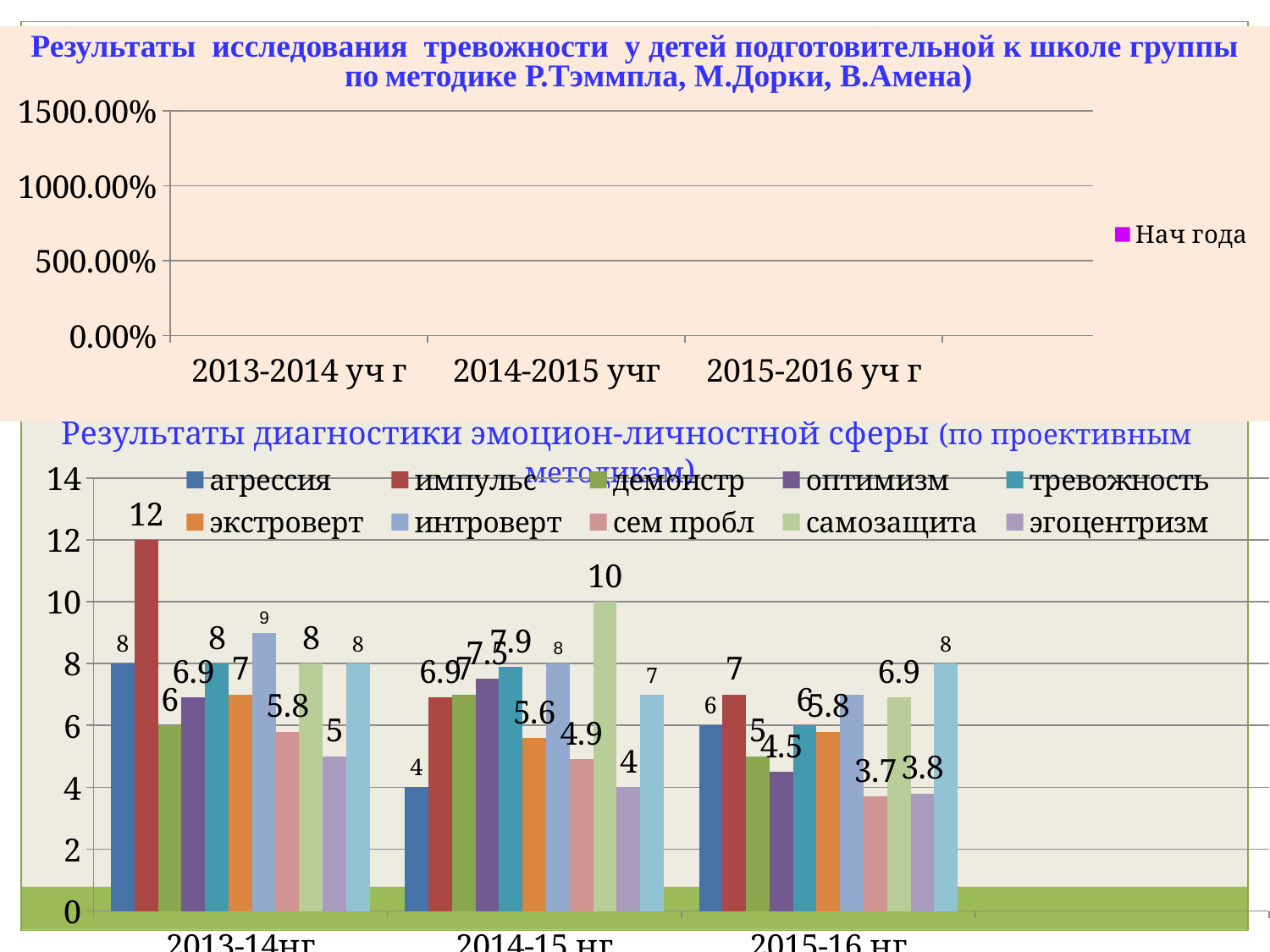
In the bottom chart 'Результаты диагностики эмоцион-личностной сферы', what is the value for импульс in 2013-14нг? 12 In the bottom chart 'Результаты диагностики эмоцион-личностной сферы', what is the difference between the импульс value in 2013-14нг and in 2014-15 нг? 5.1 In the bottom chart 'Результаты диагностики эмоцион-личностной сферы', what is the value for самозащита in 2014-15 нг? 10 In the bottom chart 'Результаты диагностики эмоцион-личностной сферы', how many series does the legend list? 10 In the bottom chart 'Результаты диагностики эмоцион-личностной сферы', how many year categories are shown on the x axis? 3 In the bottom chart 'Результаты диагностики эмоцион-личностной сферы', which series has the highest value in 2013-14нг? импульс In the bottom chart 'Результаты диагностики эмоцион-личностной сферы', do the values for сем пробл rise or fall from 2013-14нг to 2015-16 нг? fall What kind of chart is the bottom chart titled 'Результаты диагностики эмоцион-личностной сферы'? bar chart In the bottom chart 'Результаты диагностики эмоцион-личностной сферы', which series has the highest value in 2014-15 нг? самозащита In the top chart about тревожность by the method of Р.Тэммпла, М.Дорки, В.Амена, what entry does the legend show? Нач года In the bottom chart 'Результаты диагностики эмоцион-личностной сферы', is the агрессия value larger in 2013-14нг or in 2014-15 нг? 2013-14нг In the bottom chart 'Результаты диагностики эмоцион-личностной сферы', what is the value for сем пробл in 2015-16 нг? 3.7